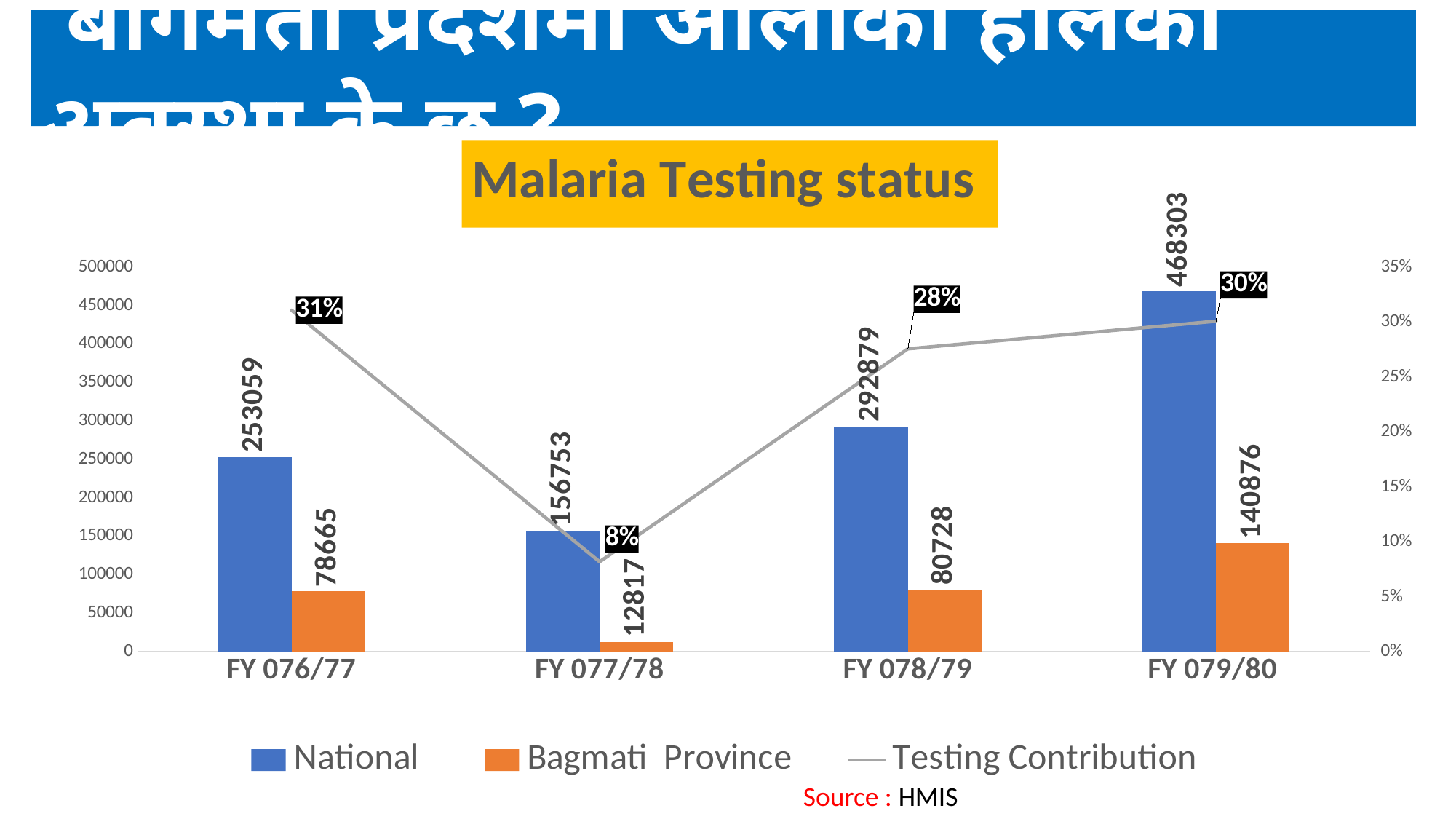
Which fiscal year has the lowest Testing Contribution? FY 077/78 What is the title of the chart? Malaria Testing status What is the difference between the National and Bagmati Province values for FY 076/77? 174394 What is the National value for FY 079/80? 468303 How many fiscal years are shown on the x axis? 4 Is the National value for FY 077/78 greater or less than 200000? less Which is larger, the Bagmati Province value for FY 078/79 or for FY 076/77? FY 078/79 What kind of chart is used for the National and Bagmati Province series? bar chart What is the Testing Contribution for FY 078/79? 28% How many series does the legend list? 3 What is the Bagmati Province value for FY 077/78? 12817 Which fiscal year has the highest National value? FY 079/80